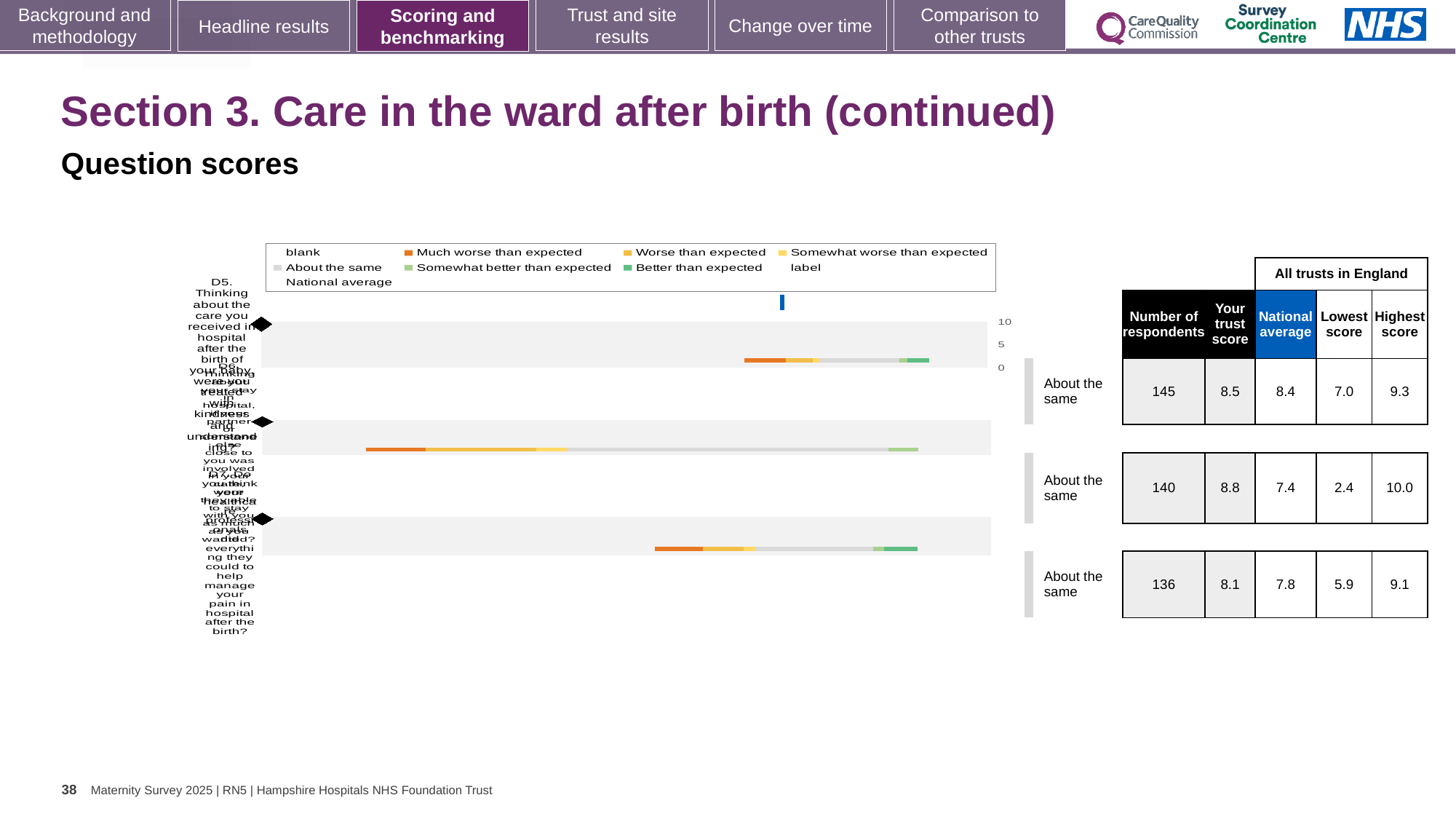
In the table beside the chart, what is the trust score for the second row? 8.8 How many horizontal bars are plotted in the chart? 3 In the table beside the chart, which row has the highest 'Highest score' value? the second row (10.0) What colour does the legend use for 'Better than expected'? green How many entries does the chart legend list? 9 What colour does the legend use for 'Much worse than expected'? orange What kind of chart is shown on the slide? bar chart What benchmark label is shown to the right of the first bar in the chart? About the same In the table beside the chart, what is the national average for the third row? 7.8 What is the highest tick value shown on the chart's axis? 10 What benchmark label is shown to the right of the third bar in the chart? About the same In the table beside the chart, what is the number of respondents for the first row? 145